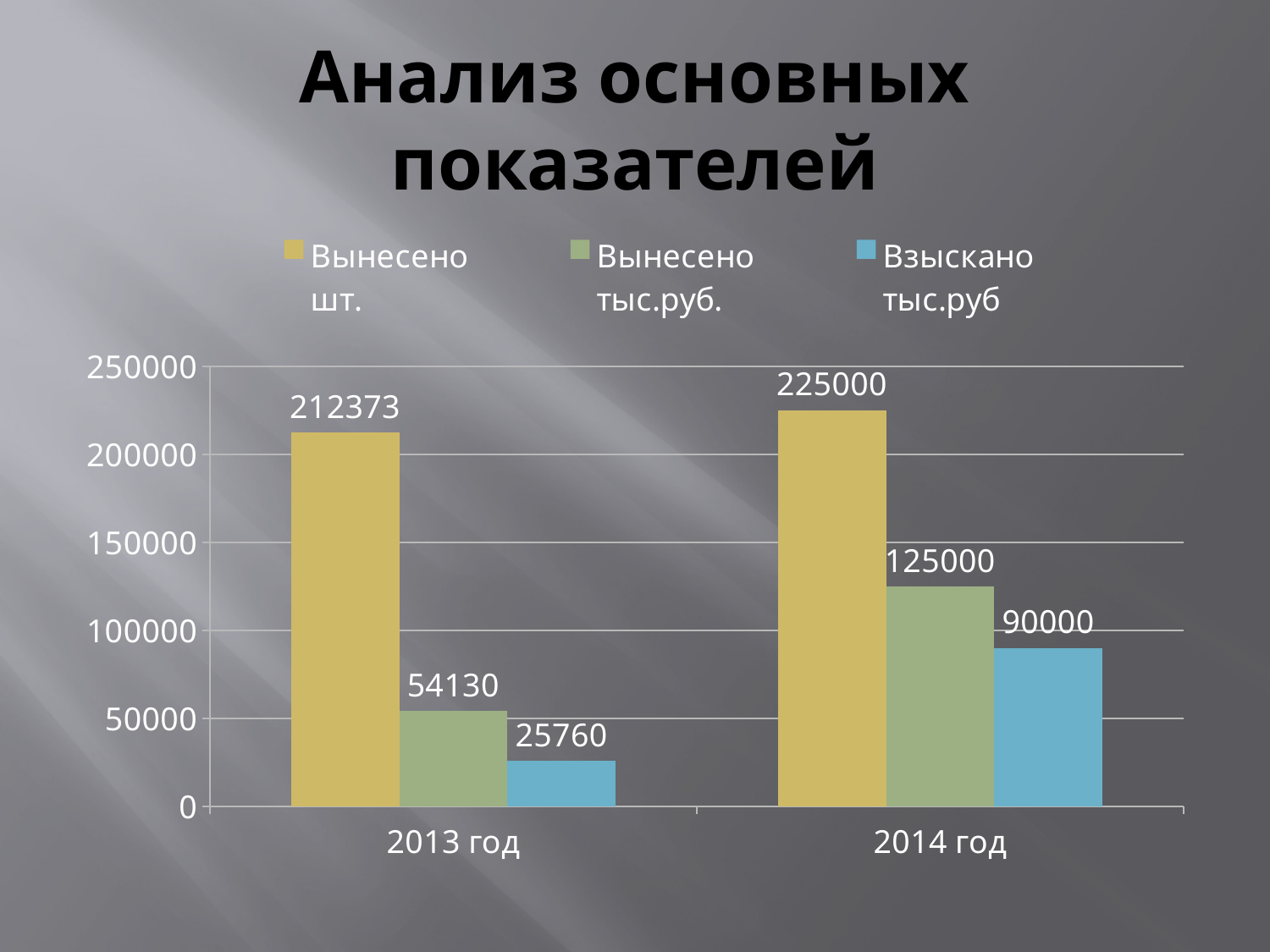
How many series does the legend list? 3 What is the difference between "Взыскано тыс.руб" in 2014 год and in 2013 год? 64240 Which series has the lowest value in 2013 год? Взыскано тыс.руб What is the value of "Вынесено тыс.руб." for 2013 год? 54130 How many categories are shown on the x axis? 2 What is the title of the slide? Анализ основных показателей What is the value of "Вынесено шт." for 2013 год? 212373 What is the value of "Взыскано тыс.руб" for 2014 год? 90000 Which year has the higher value for "Вынесено тыс.руб."? 2014 год What kind of chart is shown on the slide? Bar chart Does the value of "Взыскано тыс.руб" rise or fall from 2013 год to 2014 год? Rise What is the difference between "Вынесено шт." in 2014 год and in 2013 год? 12627